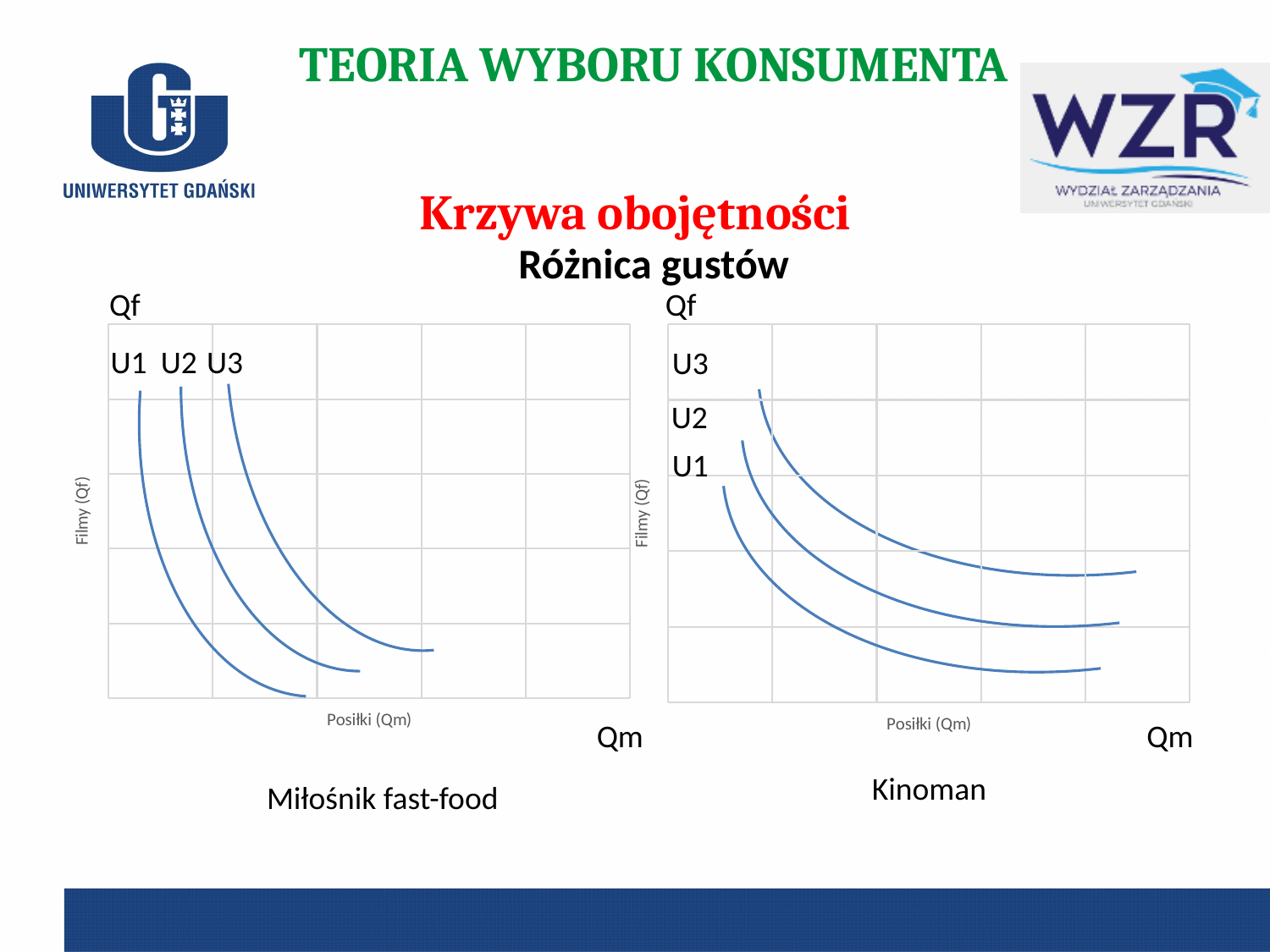
What kind of chart is the 'Miłośnik fast-food' chart on the left? Line chart How many curves are plotted on the 'Miłośnik fast-food' chart on the left? 3 What is the y-axis label on the 'Miłośnik fast-food' chart on the left? Filmy (Qf) What is the x-axis label on the 'Kinoman' chart on the right? Posiłki (Qm) On the 'Miłośnik fast-food' chart on the left, which curve lies furthest from the origin: U1, U2 or U3? U3 How many curves are plotted on the 'Kinoman' chart on the right? 3 On the 'Kinoman' chart on the right, which curve lies closest to the origin: U1, U2 or U3? U1 What kind of chart is the 'Kinoman' chart on the right? Line chart On the 'Miłośnik fast-food' chart on the left, do the curves rise or fall as Qm increases along the x axis? Fall On the 'Kinoman' chart on the right, do the curves rise or fall as Qm increases along the x axis? Fall